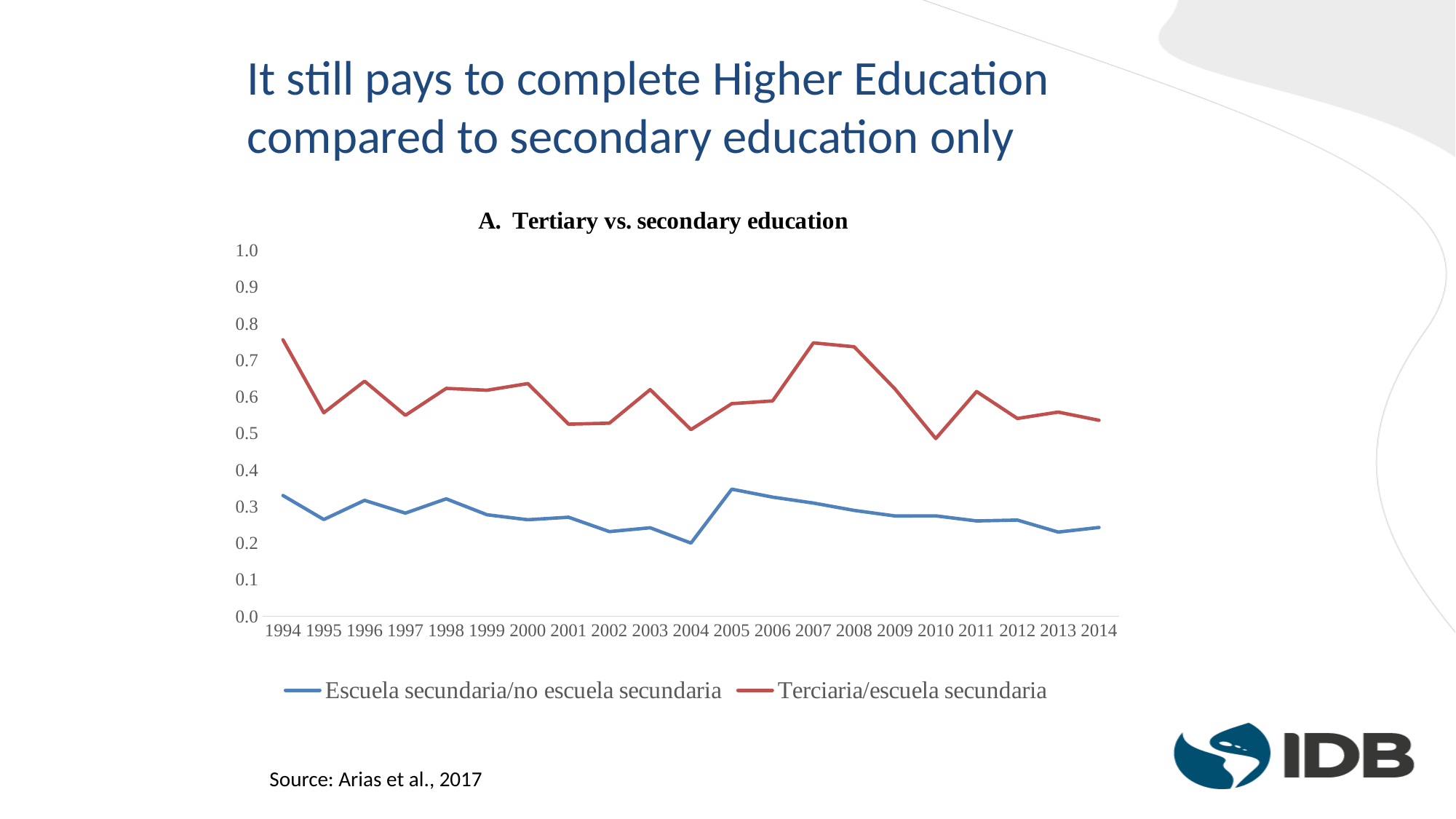
In which year is the Escuela secundaria/no escuela secundaria series at its lowest? 2004 Is the value for Terciaria/escuela secundaria in 1994 greater or less than 0.7? greater In which year is the Terciaria/escuela secundaria series at its lowest? 2010 Is the value for Escuela secundaria/no escuela secundaria in 2005 greater or less than 0.3? greater Is the value for Terciaria/escuela secundaria in 2010 greater or less than 0.5? less How many series does the legend list? 2 What is the title of the chart? A. Tertiary vs. secondary education Does the Terciaria/escuela secundaria series rise or fall between 2007 and 2010? fall How many years are plotted along the x axis? 21 What kind of chart is shown on the slide? line chart In 2000, which series has the larger value, Terciaria/escuela secundaria or Escuela secundaria/no escuela secundaria? Terciaria/escuela secundaria Which series is drawn in red? Terciaria/escuela secundaria